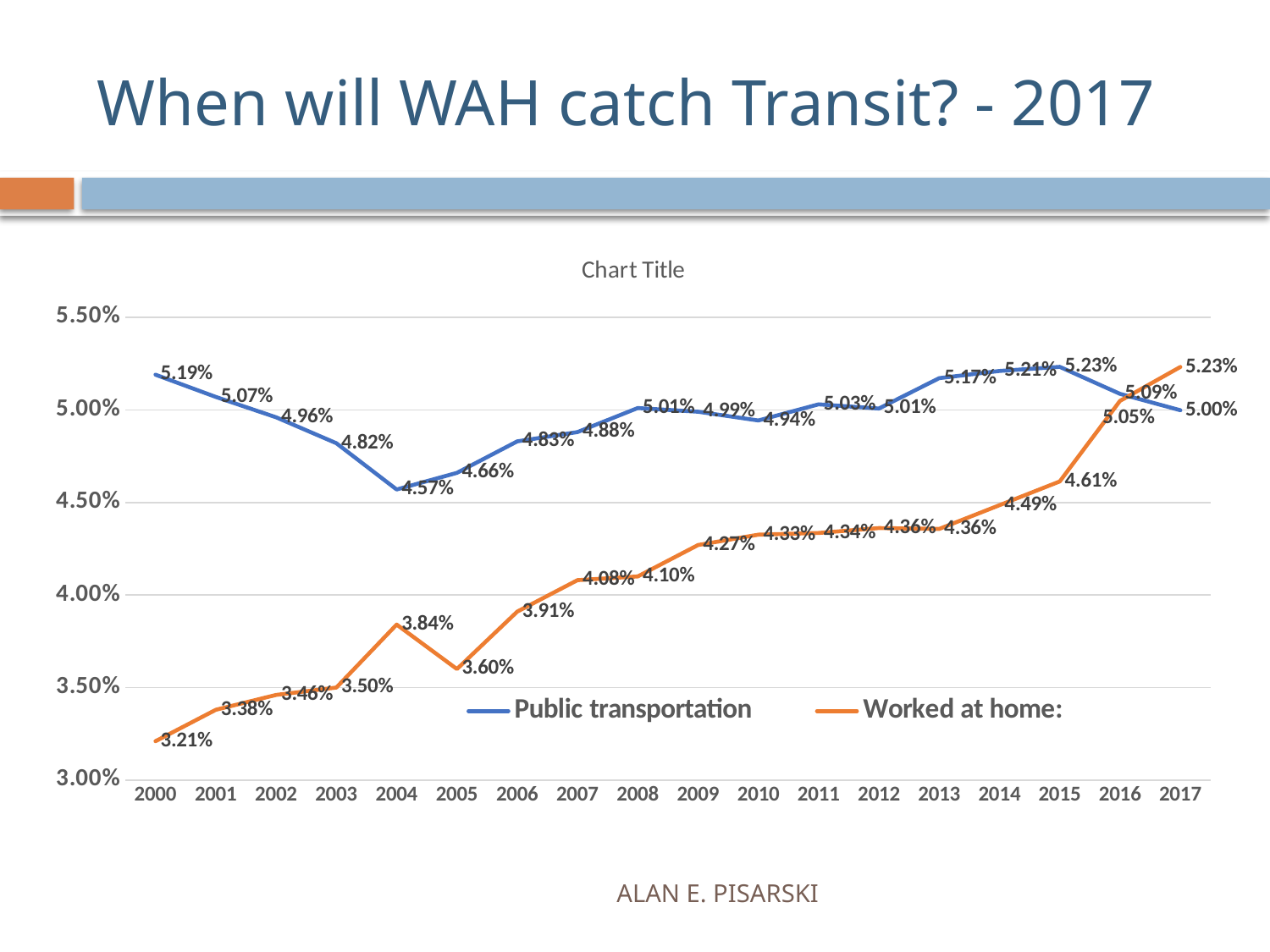
Which series has the larger value in 2010, Public transportation or Worked at home? Public transportation In which year is the Public transportation series at its lowest? 2004 What is the value for Worked at home in 2000? 3.21% What is the difference between Public transportation and Worked at home in 2000? 1.98% In which year is the Worked at home series at its highest? 2017 How many series does the legend list? 2 How many years are shown on the x axis? 18 What is the value for Worked at home in 2017? 5.23% Which series has the larger value in 2017, Public transportation or Worked at home? Worked at home What kind of chart is shown on the slide? Line chart Does the Worked at home series generally rise or fall from 2000 to 2017? Rise What is the value for Public transportation in 2004? 4.57%